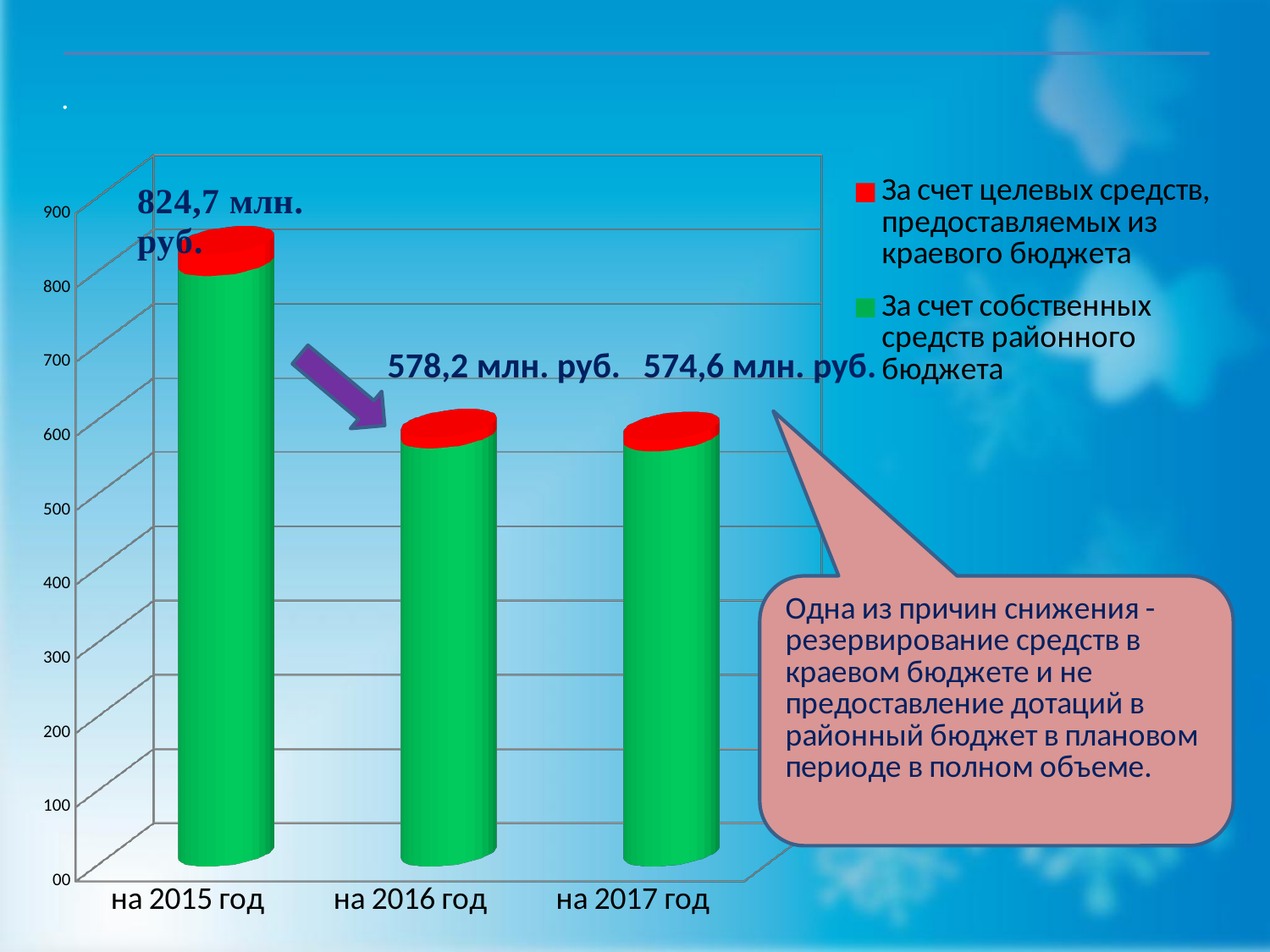
How many series does the legend list? 2 What is the total value shown for на 2017 год? 574,6 млн. руб. What is the difference between the totals for на 2016 год and на 2017 год? 3,6 млн. руб. Which year has the highest total value? на 2015 год Do the total values rise or fall from 2015 to 2017? fall What is the total value shown for на 2016 год? 578,2 млн. руб. What is the total value shown for на 2015 год? 824,7 млн. руб. Which is larger, the total for на 2016 год or for на 2017 год? на 2016 год Which year has the lowest total value? на 2017 год How many years are shown on the x axis? 3 Is the green segment (собственные средства районного бюджета) for на 2016 год greater or less than 600? less What is the difference between the totals for на 2015 год and на 2016 год? 246,5 млн. руб.